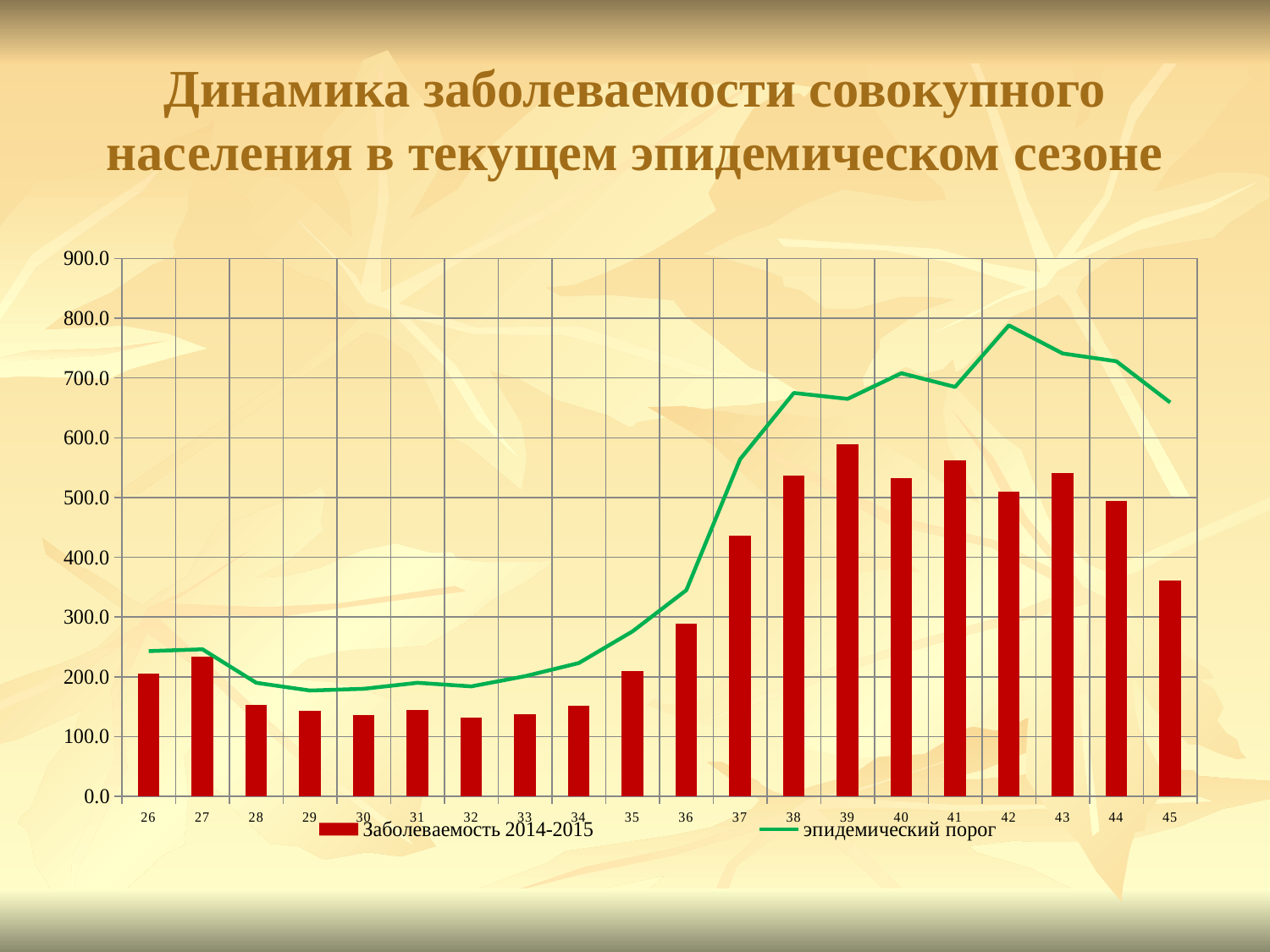
What colour is the эпидемический порог line? Green How many weeks (categories) are plotted along the x axis? 20 Is the Заболеваемость 2014-2015 value for week 28 greater or less than 200? less Is the Заболеваемость 2014-2015 value for week 39 greater or less than 500? greater Does the эпидемический порог line rise or fall from week 42 to week 45? Fall How many series does the legend list? 2 Do the Заболеваемость 2014-2015 bars rise or fall from week 32 to week 39? Rise Which week has the highest bar for Заболеваемость 2014-2015? 39 Which is larger, the Заболеваемость 2014-2015 bar for week 38 or for week 39? Week 39 Is the эпидемический порог value for week 42 greater or less than 700? greater What kind of chart is shown on the slide? A bar chart combined with a line